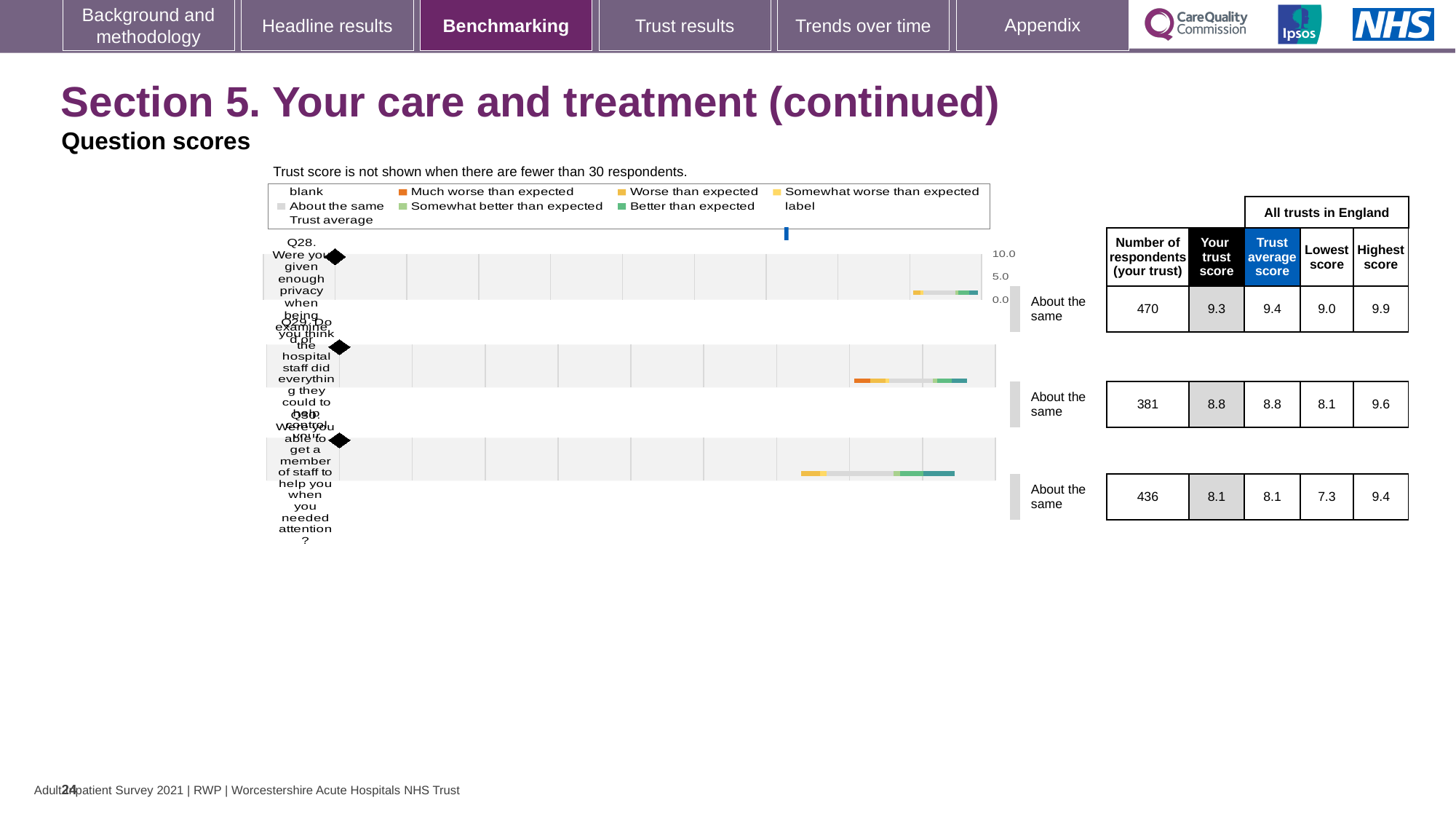
For Q30, what is the difference between the trust average score and the lowest score? 0.8 Which of the three questions shown has the highest 'Your trust score'? Q28 What benchmark category is shown next to the chart for Q30? About the same Which of the three questions shown has the lowest 'Lowest score' among all trusts in England? Q30 How many respondents from the trust answered Q29 (Do you think the hospital staff did everything they could to help control your pain?)? 381 What is the 'Your trust score' value for Q28 (Were you given enough privacy when being examined or treated?)? 9.3 How many questions are charted on this slide? 3 What is the lowest score across all trusts in England for Q29? 8.1 What is the highest score across all trusts in England for Q30 (Were you able to get a member of staff to help you when you needed attention?)? 9.4 For Q28, which is larger: the trust's own score or the trust average score? Trust average score (9.4) What kind of chart is used to show the benchmarking results for each question? Bar chart For Q28, what is the difference between the highest score and the lowest score across all trusts in England? 0.9